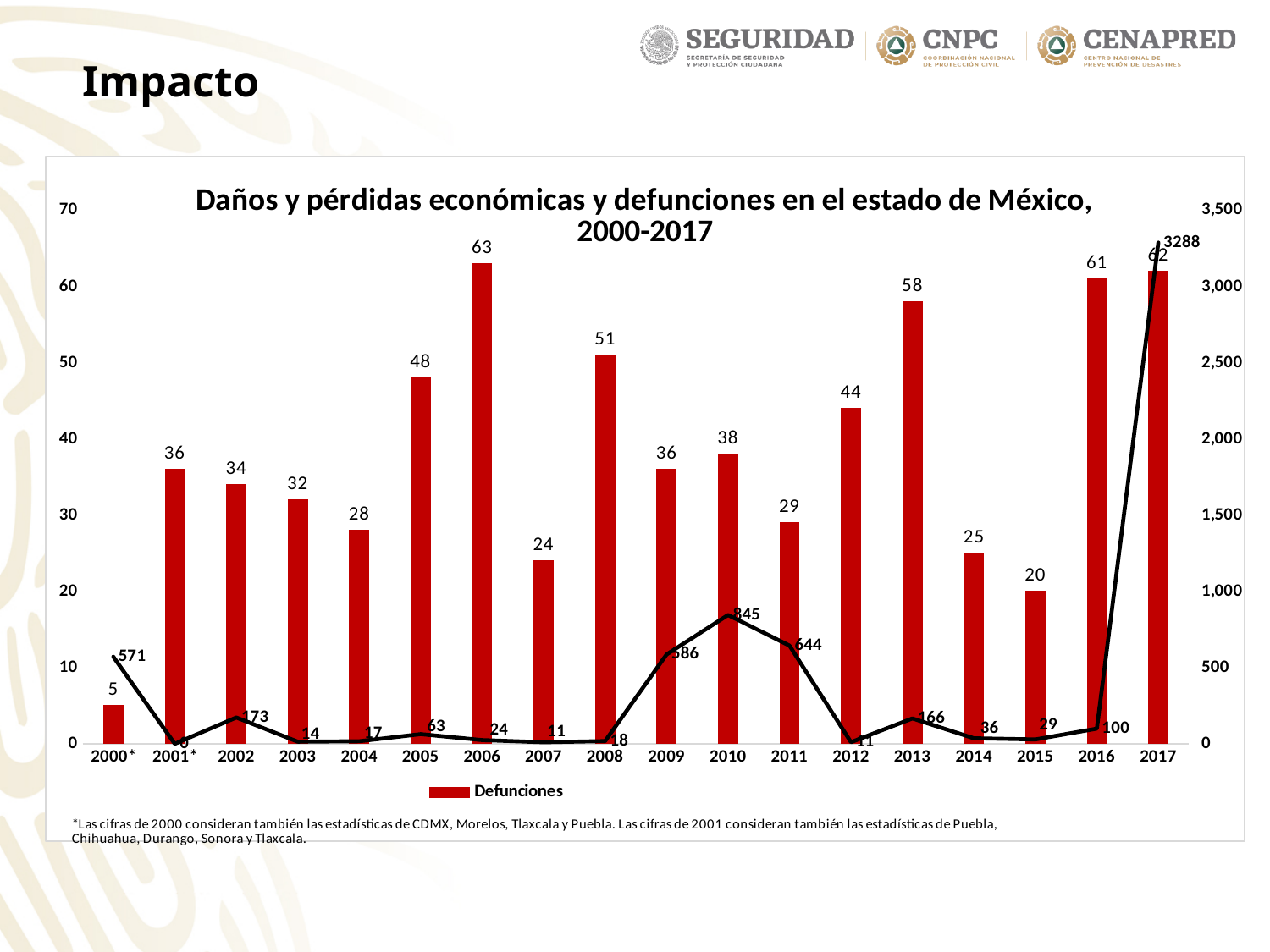
What is the difference between the Defunciones values for 2016 and 2015? 41 How many years are shown on the x axis? 18 How many series does the legend list? 1 Which year has the lowest Defunciones bar? 2000* What is the title of the chart? Daños y pérdidas económicas y defunciones en el estado de México, 2000-2017 Which is larger, the Defunciones value for 2008 or for 2012? 2008 What is the value of the Defunciones bar for 2013? 58 Which year has the highest Defunciones bar? 2006 What kind of chart is this? Combined bar and line chart Do the Defunciones bars rise or fall from 2013 to 2015? fall What value does the black line reach in 2017? 3288 What is the value of the Defunciones bar for 2006? 63